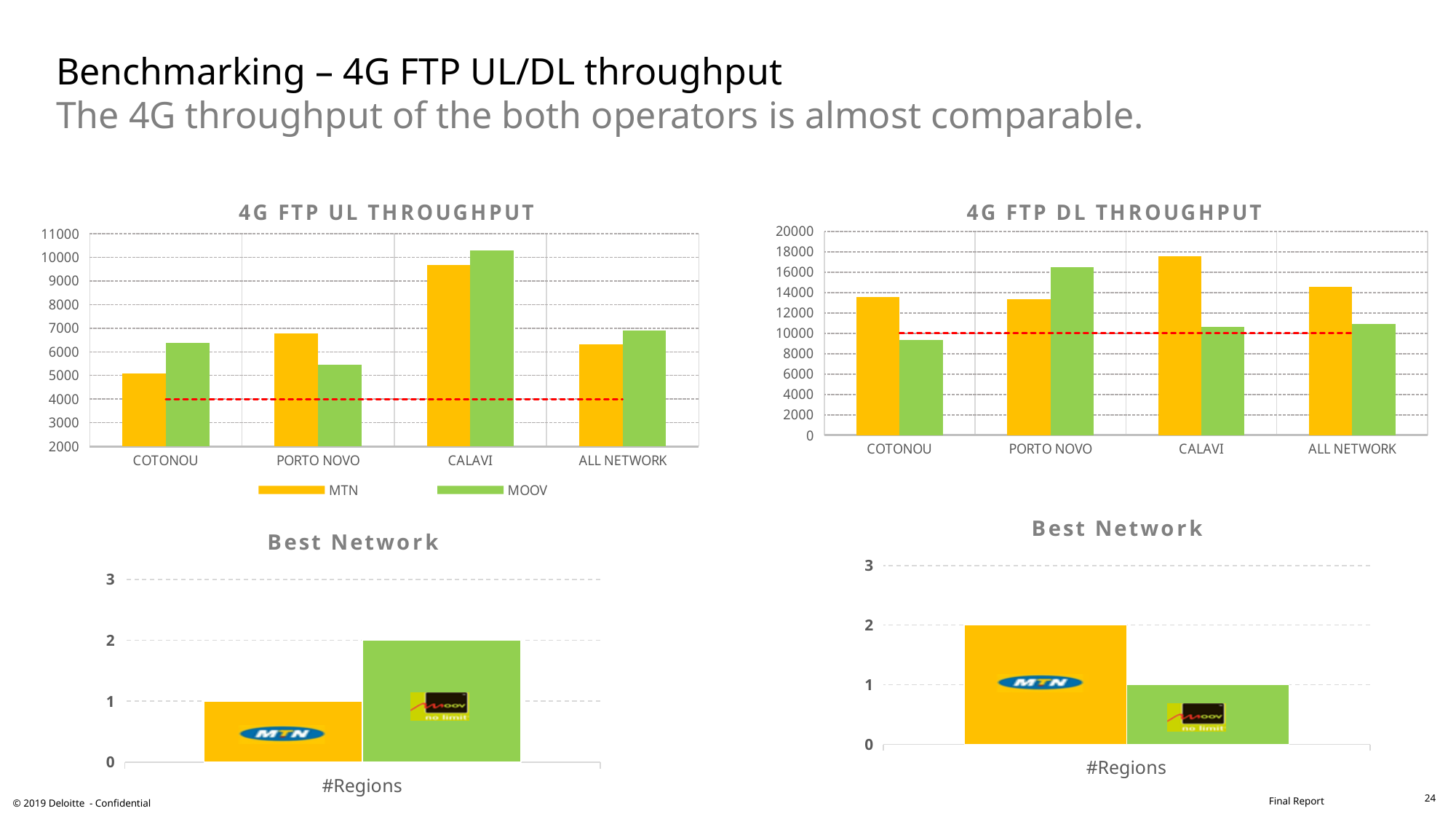
In the '4G FTP UL THROUGHPUT' chart, how many series does the legend list? 2 In the 'Best Network' chart at the bottom right, what is the value for MTN? 2 In the '4G FTP UL THROUGHPUT' chart, which category has the lowest MTN bar? COTONOU In the '4G FTP DL THROUGHPUT' chart, which is larger for PORTO NOVO, MTN or MOOV? MOOV What kind of chart is the '4G FTP UL THROUGHPUT' chart? bar chart In the '4G FTP DL THROUGHPUT' chart, which category has the highest MTN bar? CALAVI In the '4G FTP DL THROUGHPUT' chart, is the MOOV value for COTONOU greater or less than 10000? less In the '4G FTP UL THROUGHPUT' chart, how many categories are shown on the x axis? 4 In the '4G FTP DL THROUGHPUT' chart, which is larger for COTONOU, MTN or MOOV? MTN In the 'Best Network' chart at the bottom left, what is the value for MOOV? 2 In the '4G FTP UL THROUGHPUT' chart, which category has the highest MOOV bar? CALAVI In the '4G FTP UL THROUGHPUT' chart, is the MTN value for CALAVI greater or less than 9000? greater